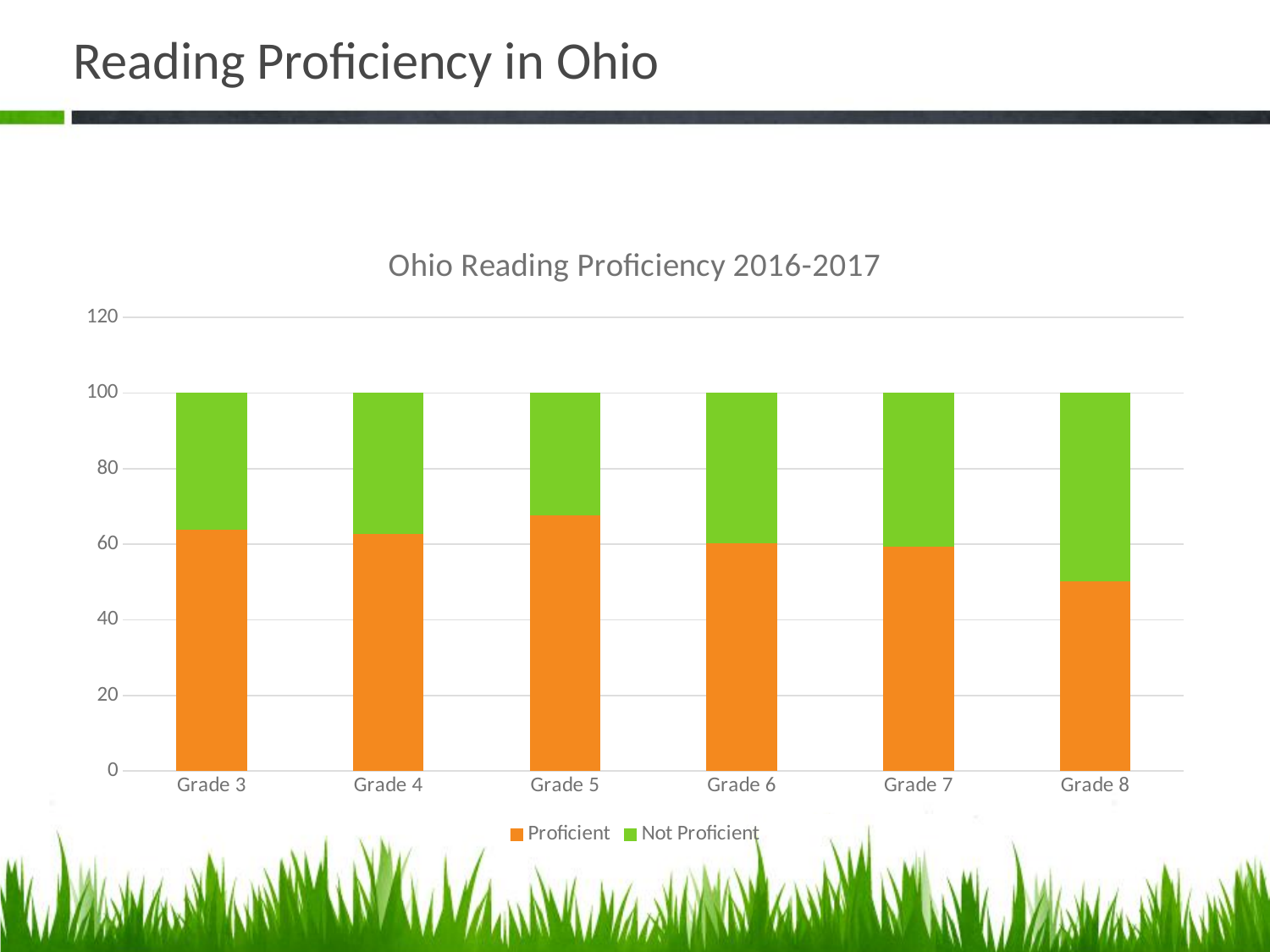
Which is larger, the Proficient value for Grade 3 or for Grade 8? Grade 3 What is the total height of the stacked bar for Grade 6? 100 Which grade has the highest Proficient value? Grade 5 Which grade has the lowest Proficient value? Grade 8 Is the Proficient value for Grade 8 greater or less than 60? less What is the title of the chart? Ohio Reading Proficiency 2016-2017 Which grade has the largest Not Proficient segment? Grade 8 What kind of chart is shown on the slide? Stacked bar chart Is the Proficient value for Grade 5 greater or less than 60? greater How many grade categories are shown on the x axis? 6 How many series does the legend list? 2 Does the Proficient value rise or fall from Grade 5 to Grade 8? Falls